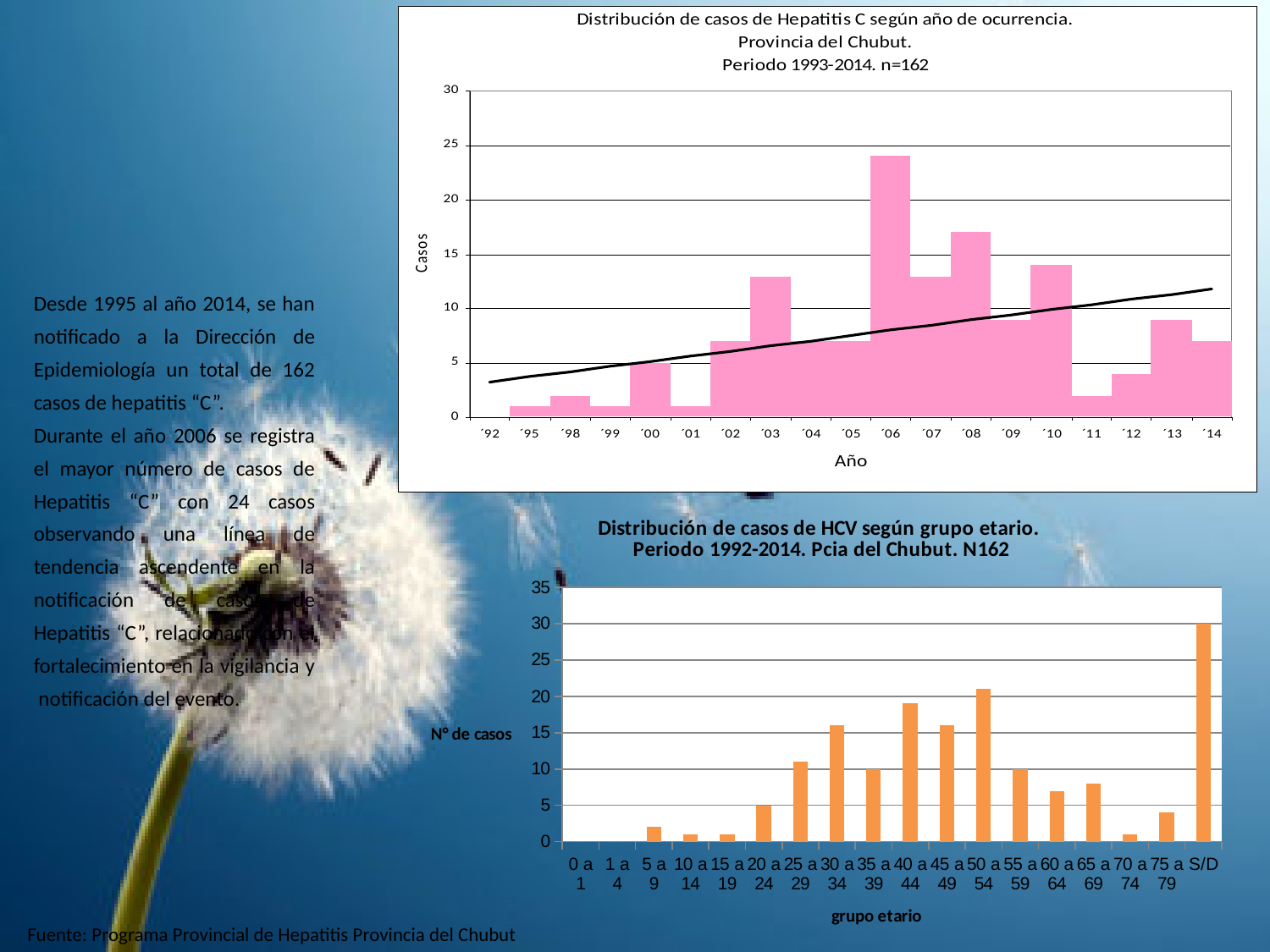
In the top chart (cases by year), which is larger, the value for '08 or the value for '09? '08 What kind of chart is the bottom chart, 'Distribución de casos de HCV según grupo etario'? Bar chart In the top chart (cases by year), what is the label on the y axis? Casos In the top chart (cases by year), which year has the highest number of cases? '06 What kind of chart is the top chart, 'Distribución de casos de Hepatitis C según año de ocurrencia'? Bar chart In the bottom chart (cases by age group), how many categories are shown on the x axis? 18 In the top chart (cases by year), is the value for '03 greater or less than 10? greater In the bottom chart (cases by age group), which category has the highest value? S/D In the top chart (cases by year), is the value for '11 greater or less than 5? less In the top chart (cases by year), is the value for '06 greater or less than 20? greater In the bottom chart (cases by age group), which is larger, the value for 40 a 44 or the value for 35 a 39? 40 a 44